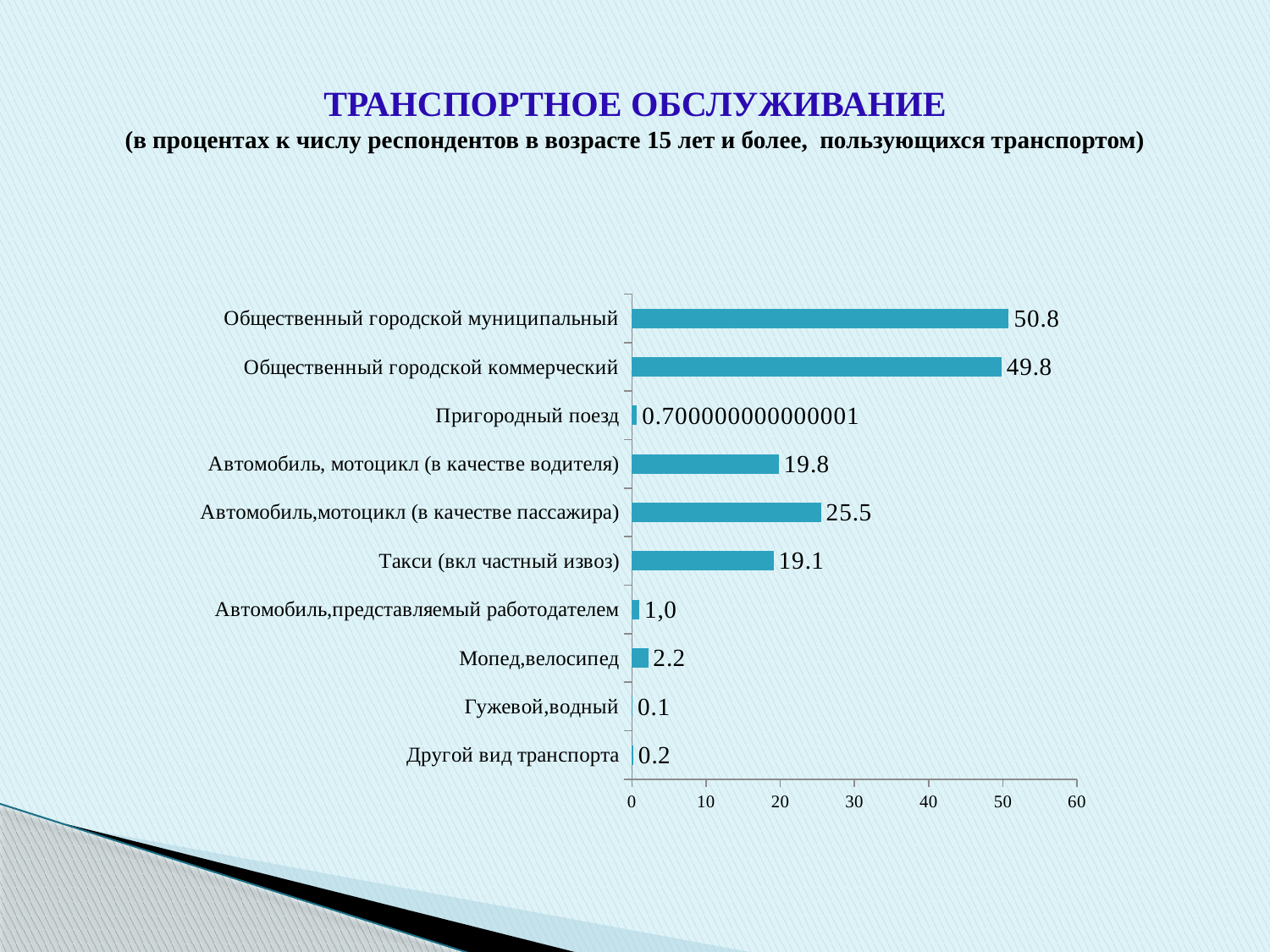
What is the value for Мопед,велосипед? 2.2 Which is larger: Автомобиль,мотоцикл (в качестве пассажира) or Такси (вкл частный извоз)? Автомобиль,мотоцикл (в качестве пассажира) What kind of chart is shown on the slide? bar chart What is the difference between Автомобиль,мотоцикл (в качестве пассажира) and Автомобиль, мотоцикл (в качестве водителя)? 5.7 What is the title of the slide? ТРАНСПОРТНОЕ ОБСЛУЖИВАНИЕ Is the value for Автомобиль, мотоцикл (в качестве водителя) greater or less than 30? less Which category has the highest value? Общественный городской муниципальный How many categories are shown in the chart? 10 What is the value for Общественный городской муниципальный? 50.8 What is the value for Такси (вкл частный извоз)? 19.1 What is the difference between Общественный городской муниципальный and Общественный городской коммерческий? 1.0 Which category has the lowest value? Гужевой,водный